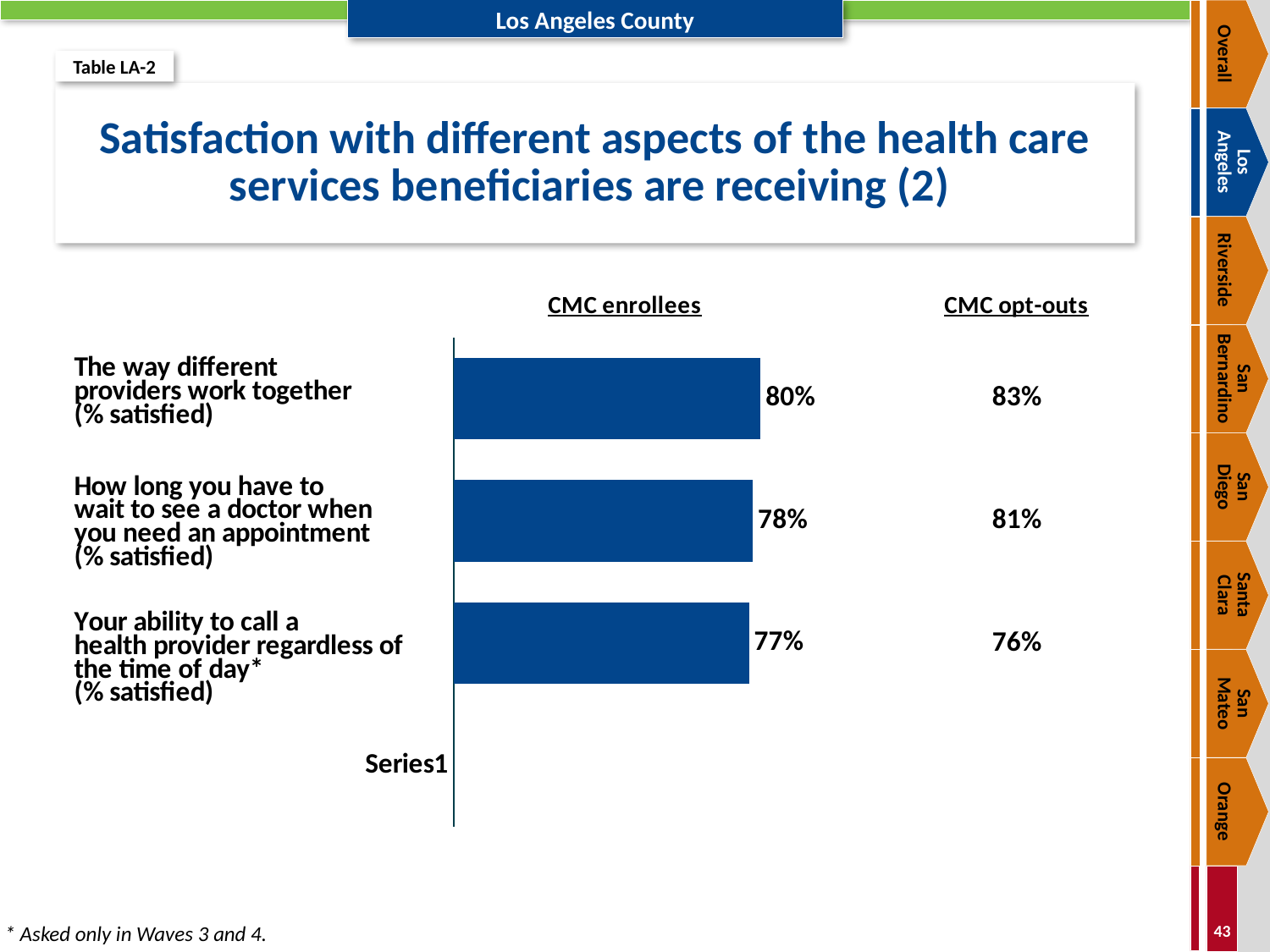
For 'How long you have to wait to see a doctor when you need an appointment', which is larger: the CMC enrollees value or the CMC opt-outs value? CMC opt-outs What is the CMC enrollees value for 'Your ability to call a health provider regardless of the time of day (% satisfied)'? 77% What is the title of the slide containing the chart? Satisfaction with different aspects of the health care services beneficiaries are receiving (2) What is the CMC opt-outs value for 'Your ability to call a health provider regardless of the time of day (% satisfied)'? 76% What is the CMC enrollees value for 'The way different providers work together (% satisfied)'? 80% What kind of chart is shown on the slide? Bar chart How many aspects of health care services are plotted as bars in the chart? 3 What is the CMC opt-outs value for 'The way different providers work together (% satisfied)'? 83% Which aspect has the highest CMC enrollees satisfaction value? The way different providers work together What is the difference between the CMC enrollees values for 'The way different providers work together' and 'Your ability to call a health provider regardless of the time of day'? 3% Which aspect has the lowest CMC enrollees satisfaction value? Your ability to call a health provider regardless of the time of day What is the CMC enrollees value for 'How long you have to wait to see a doctor when you need an appointment (% satisfied)'? 78%